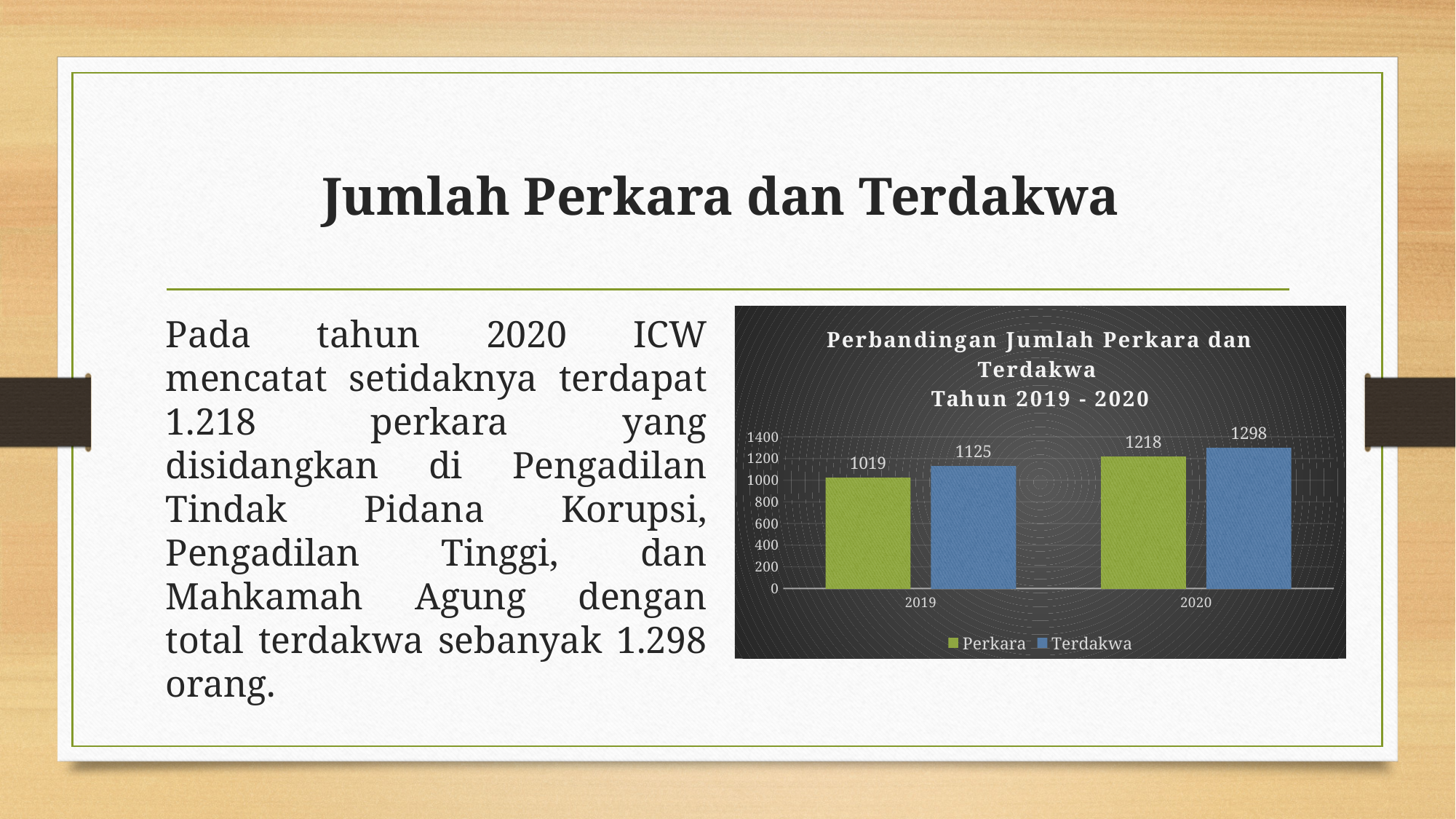
What is the difference between Terdakwa and Perkara in 2020? 80 What kind of chart is shown on the slide? Bar chart What is the difference between the Terdakwa values for 2020 and 2019? 173 What is the value of Perkara for 2019? 1019 Which year has the higher Perkara value? 2020 What is the value of Terdakwa for 2020? 1298 Which is larger in 2019, Perkara or Terdakwa? Terdakwa What is the value of Perkara for 2020? 1218 Which bar has the lowest value in the chart? Perkara in 2019 Do the Perkara values rise or fall from 2019 to 2020? Rise What is the value of Terdakwa for 2019? 1125 How many series does the legend list? 2